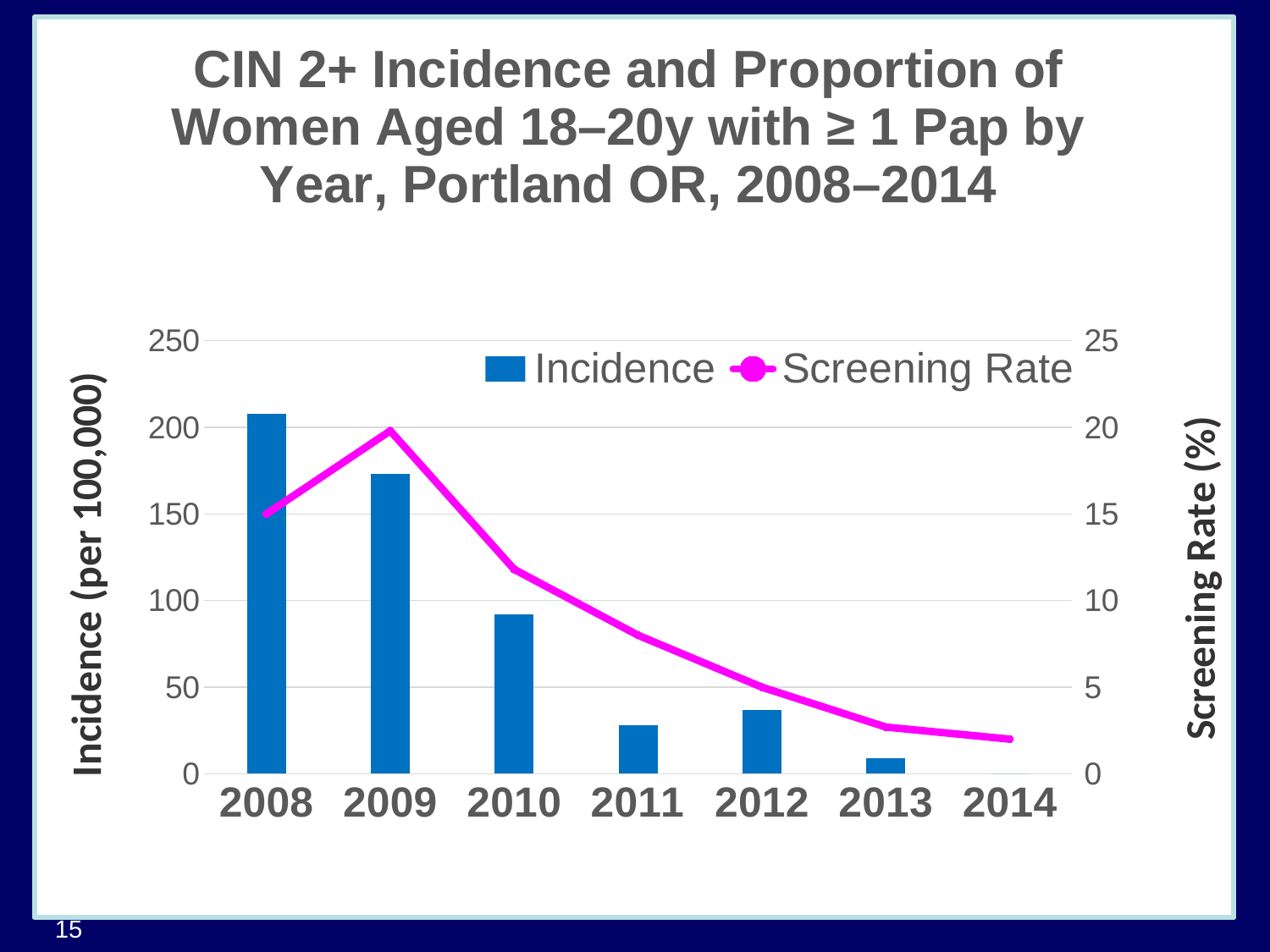
Is the Incidence value for 2010 greater or less than 100? less How many years are shown on the x axis? 7 Which year has the highest Screening Rate? 2009 Which year has a higher Incidence, 2011 or 2012? 2012 Which year has the highest Incidence bar? 2008 Is the Screening Rate for 2009 greater or less than 15? greater What is the label of the right-hand vertical axis? Screening Rate (%) Is the Incidence value for 2008 greater or less than 200? greater How many series does the legend list? 2 Does the Screening Rate rise or fall from 2009 to 2014? fall Which year has the lowest Incidence bar? 2014